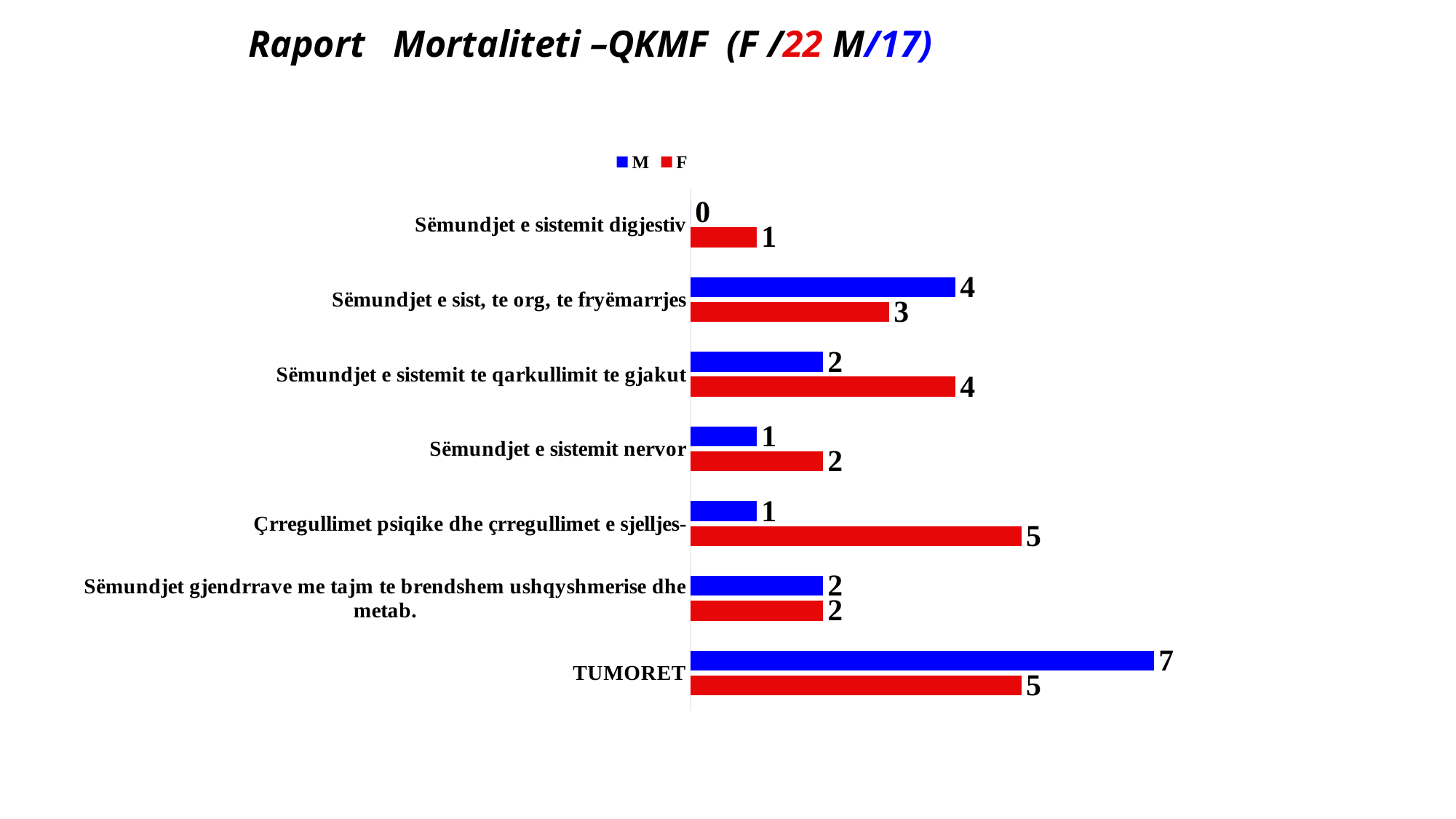
What is the M value for TUMORET? 7 How many series does the legend list? 2 What is the F value for Çrregullimet psiqike dhe çrregullimet e sjelljes-? 5 What colour represents the F series in the chart? Red What is the difference between the M and F values for TUMORET? 2 Which category has the lowest M value? Sëmundjet e sistemit digjestiv Which is larger for Sëmundjet e sistemit te qarkullimit te gjakut, the M value or the F value? F How many categories are shown in the chart? 7 Which category has the highest M value? TUMORET What kind of chart is shown on the slide? Bar chart What is the M value for Sëmundjet e sistemit digjestiv? 0 What is the F value for Sëmundjet e sist, te org, te fryëmarrjes? 3